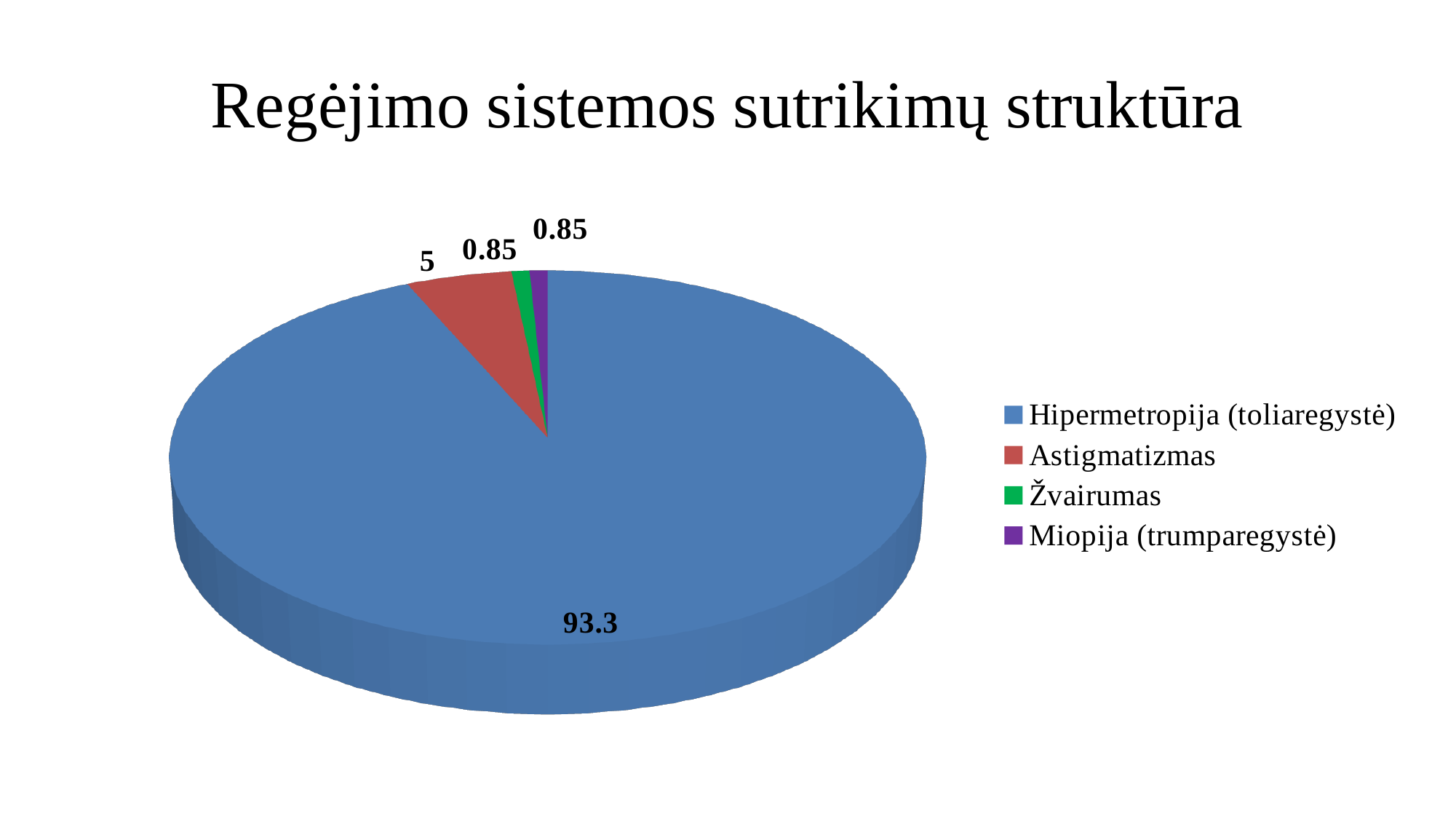
What is the value shown for Astigmatizmas? 5 Which category has the largest slice of the pie? Hipermetropija (toliaregystė) How many slices does the pie chart have? 4 What is the title of the chart? Regėjimo sistemos sutrikimų struktūra Which is larger, the value for Astigmatizmas or the value for Žvairumas? Astigmatizmas What is the value shown for Miopija (trumparegystė)? 0.85 How many entries does the legend list? 4 What kind of chart is shown on the slide? pie chart What is the difference between the values for Hipermetropija (toliaregystė) and Astigmatizmas? 88.3 What is the value shown for Žvairumas? 0.85 What colour is the slice for Astigmatizmas? red What is the value shown for Hipermetropija (toliaregystė)? 93.3